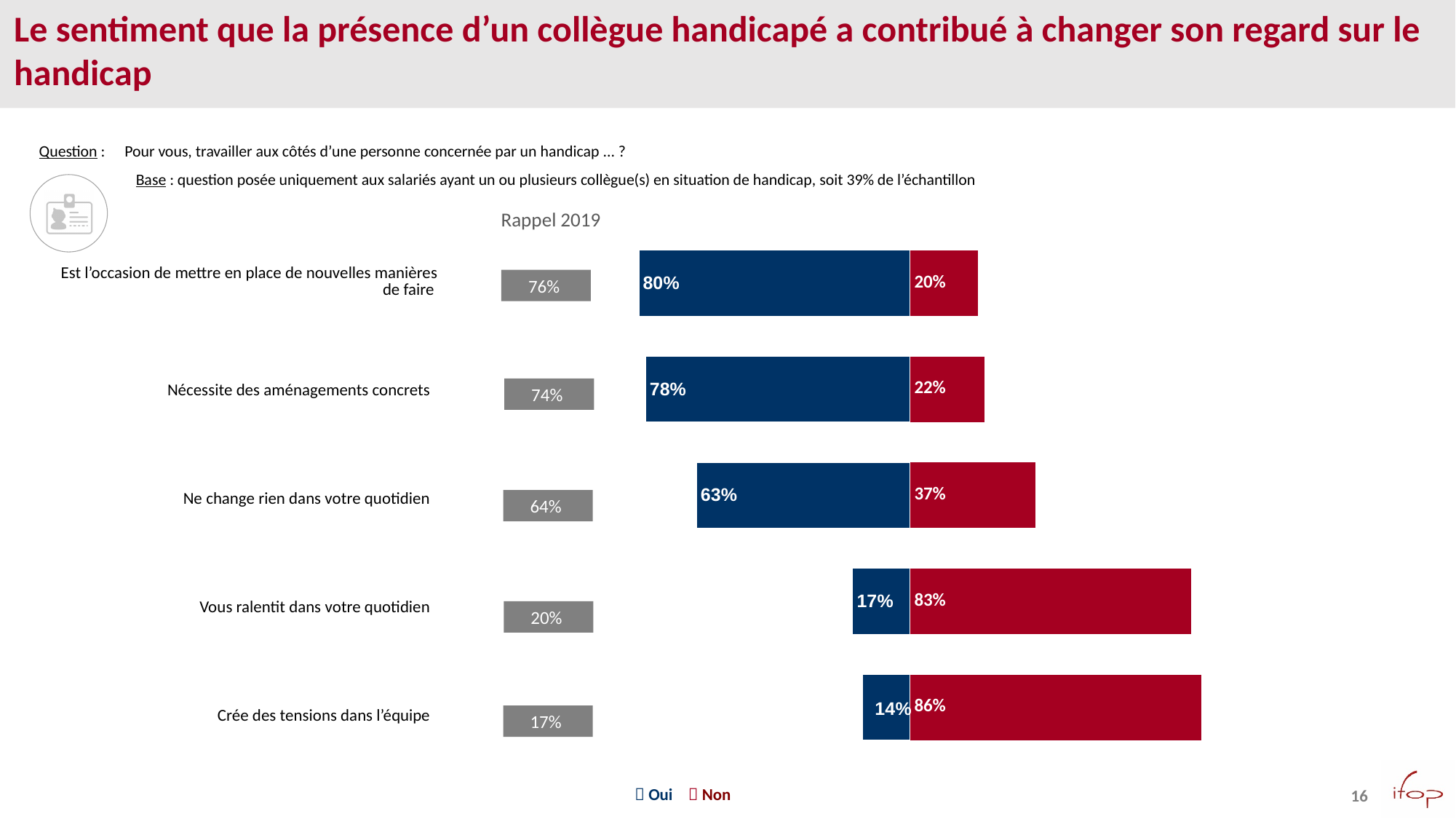
Which is larger: the "Oui" value for "Nécessite des aménagements concrets" or the "Oui" value for "Ne change rien dans votre quotidien"? Nécessite des aménagements concrets What is the difference between the "Non" values for "Crée des tensions dans l'équipe" and "Vous ralentit dans votre quotidien"? 3% Which category has the highest "Oui" value? Est l'occasion de mettre en place de nouvelles manières de faire How many categories are shown in the chart? 5 What is the "Oui" value for "Crée des tensions dans l'équipe"? 14% What kind of chart is shown on the slide? Stacked bar chart What is the "Rappel 2019" value shown for "Vous ralentit dans votre quotidien"? 20% What is the total of the stacked bar for "Nécessite des aménagements concrets"? 100% What is the "Non" value for "Ne change rien dans votre quotidien"? 37% Which category has the lowest "Oui" value? Crée des tensions dans l'équipe What is the "Oui" value for "Est l'occasion de mettre en place de nouvelles manières de faire"? 80% How many series does the legend list? 2